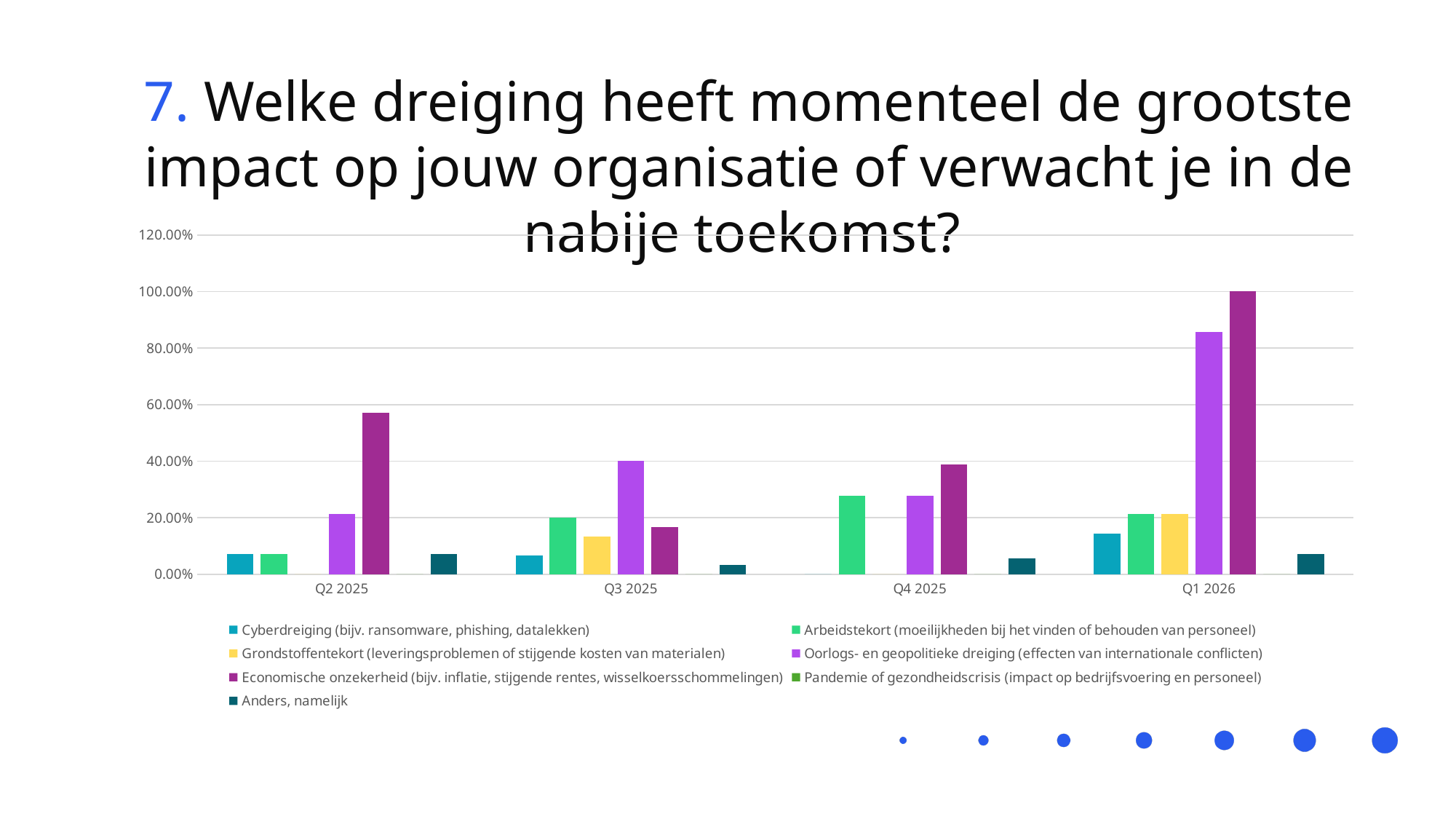
What kind of chart is shown on the slide? Bar chart Which series has the highest value in Q1 2026? Economische onzekerheid (bijv. inflatie, stijgende rentes, wisselkoersschommelingen) Which series has the highest value in Q2 2025? Economische onzekerheid (bijv. inflatie, stijgende rentes, wisselkoersschommelingen) How many quarters (categories) are shown on the x axis? 4 How many series does the legend list? 7 Which is larger: the value for Economische onzekerheid in Q2 2025 or in Q3 2025? Q2 2025 Is the value for Oorlogs- en geopolitieke dreiging in Q1 2026 greater or less than 80%? greater Is the value for Economische onzekerheid in Q2 2025 greater or less than 40%? greater What is the value for Economische onzekerheid in Q1 2026? 100.00% Which colour represents Anders, namelijk in the legend? Dark teal Is the value for Cyberdreiging in Q2 2025 greater or less than 20%? less Which series has the highest value in Q3 2025? Oorlogs- en geopolitieke dreiging (effecten van internationale conflicten)